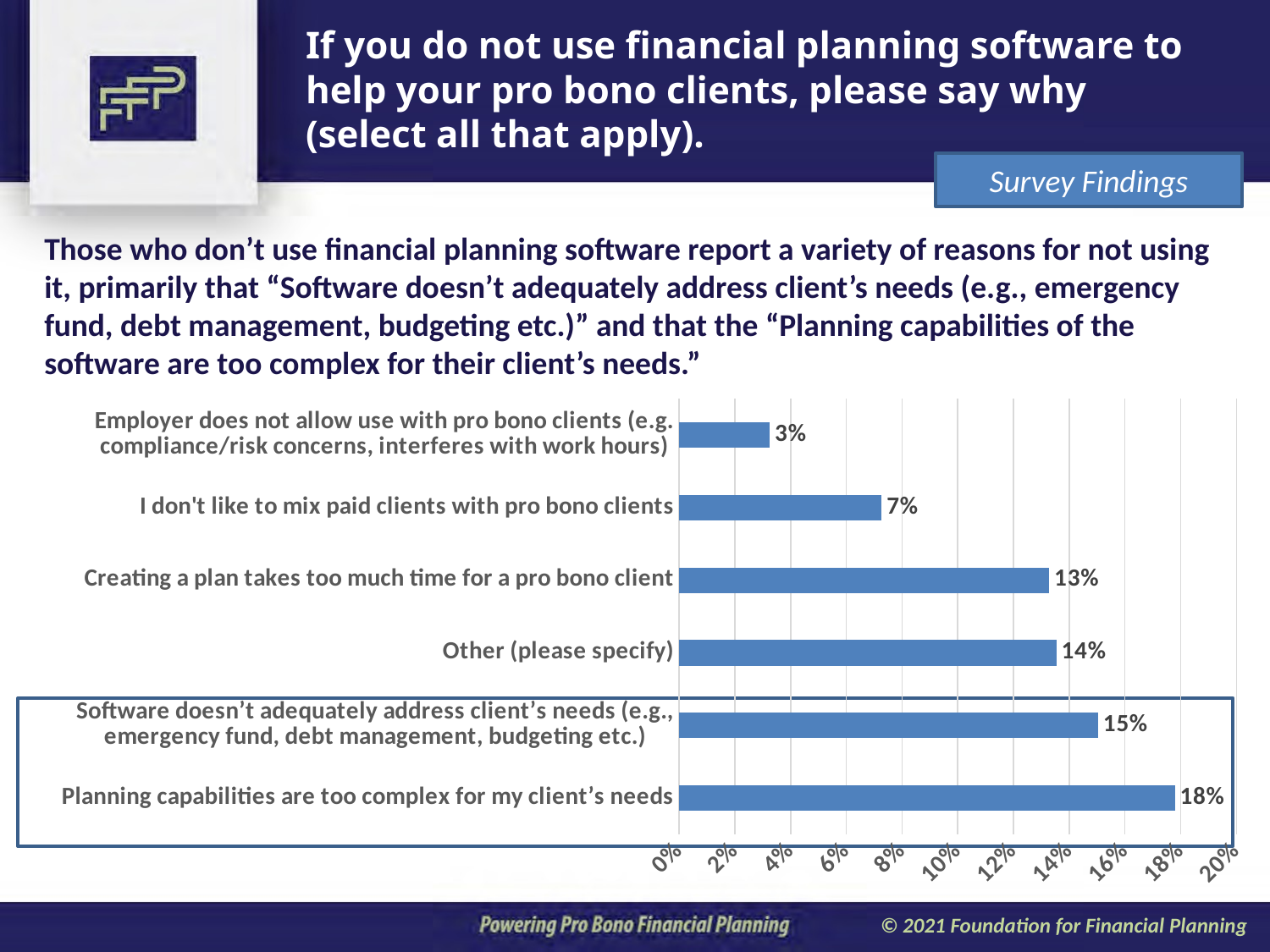
What kind of chart is shown on the slide? Bar chart Which reason has the highest percentage? Planning capabilities are too complex for my client's needs Which reason has the lowest percentage? Employer does not allow use with pro bono clients (e.g. compliance/risk concerns, interferes with work hours) Which is larger: the value for "Other (please specify)" or the value for "Creating a plan takes too much time for a pro bono client"? Other (please specify) Is the value for "Software doesn't adequately address client's needs" greater or less than 10%? greater What value is shown for "I don't like to mix paid clients with pro bono clients"? 7% How many reasons (categories) are shown in the chart? 6 What is the maximum value shown on the x axis of the chart? 20% What is the difference between the value for "Planning capabilities are too complex for my client's needs" and the value for "Software doesn't adequately address client's needs"? 3% What percentage of respondents said "Planning capabilities are too complex for my client's needs"? 18% What percentage is shown for "Other (please specify)"? 14% What value is shown for "Creating a plan takes too much time for a pro bono client"? 13%